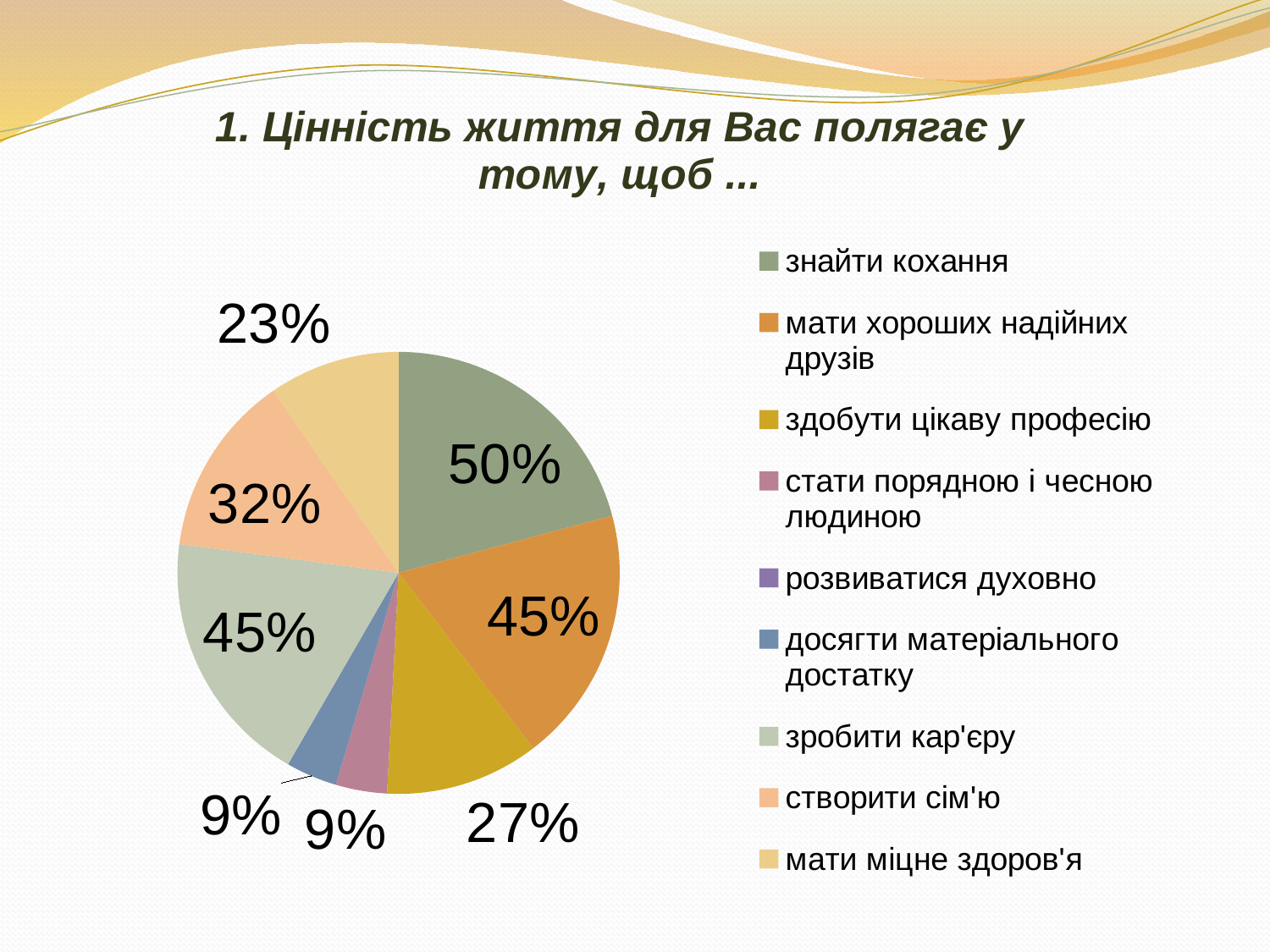
What percentage is shown for "мати міцне здоров'я"? 23% How many categories does the legend of the pie chart list? 9 What kind of chart is shown on the slide? pie chart What is the title of the slide above the chart? 1. Цінність життя для Вас полягає у тому, щоб ... What is the difference in percentage points between "знайти кохання" and "здобути цікаву професію"? 23 What percentage is shown for "мати хороших надійних друзів"? 45% Which category has the largest slice in the pie chart? знайти кохання What percentage is shown for "здобути цікаву професію"? 27% What percentage is shown for "знайти кохання"? 50% Which is larger: the value for "створити сім'ю" or for "мати міцне здоров'я"? створити сім'ю What percentage is shown for "створити сім'ю"? 32%